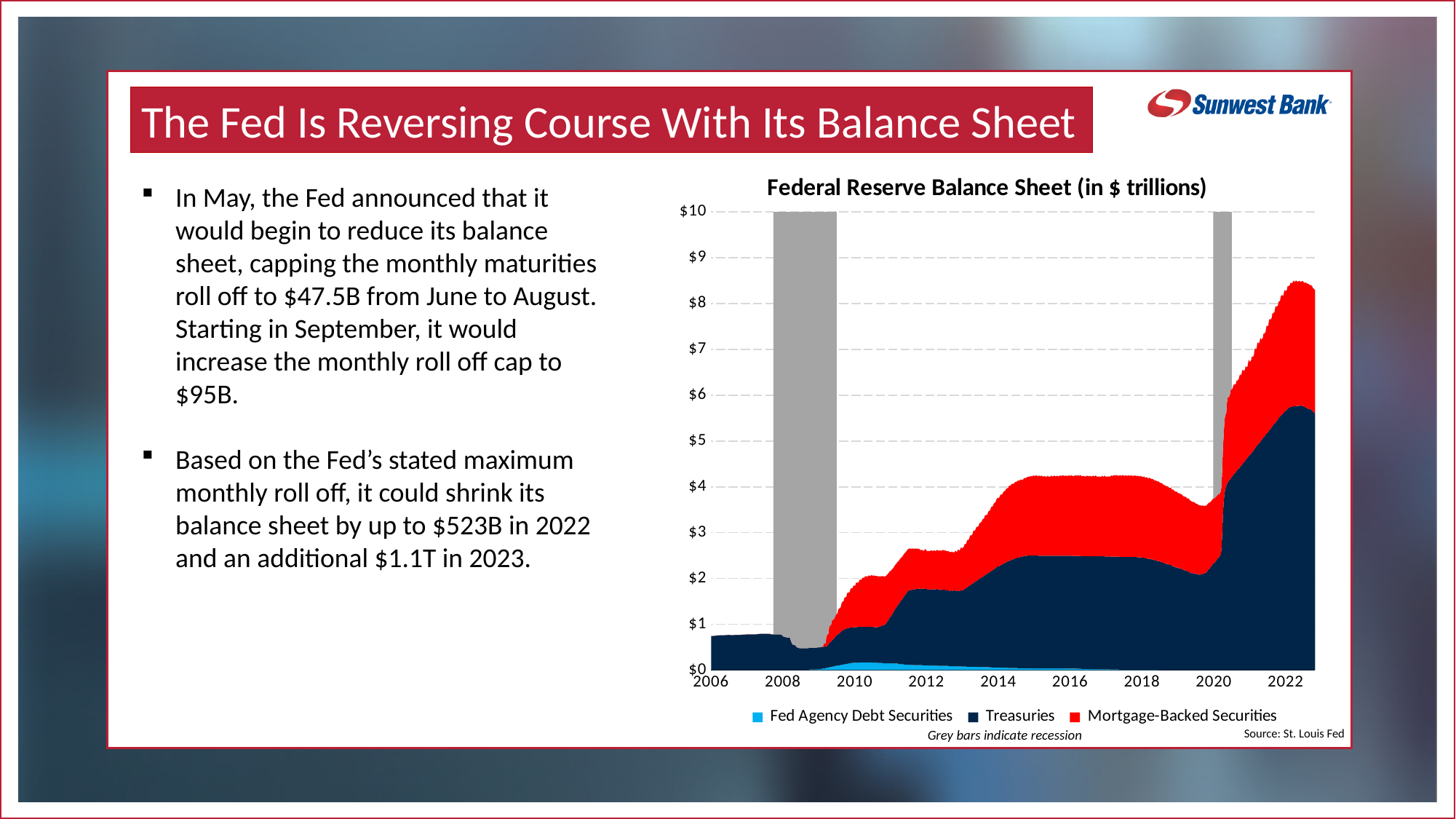
What is the title of the chart on the slide? Federal Reserve Balance Sheet (in $ trillions) Is the total balance sheet value in 2006 greater or less than $1 trillion? less Is the Treasuries value in 2014 greater or less than $2 trillion? greater How many series does the legend of the Federal Reserve Balance Sheet chart list? 3 Is the Treasuries value in 2022 greater or less than $5 trillion? greater Does the total Federal Reserve balance sheet generally rise or fall from 2006 to 2022? Rise How many year labels are shown on the x axis of the chart? 9 In 2022, which is larger: the Treasuries holdings or the Mortgage-Backed Securities holdings? Treasuries Which series is shown in red in the Federal Reserve Balance Sheet chart? Mortgage-Backed Securities What kind of chart is shown on the slide? Stacked area chart